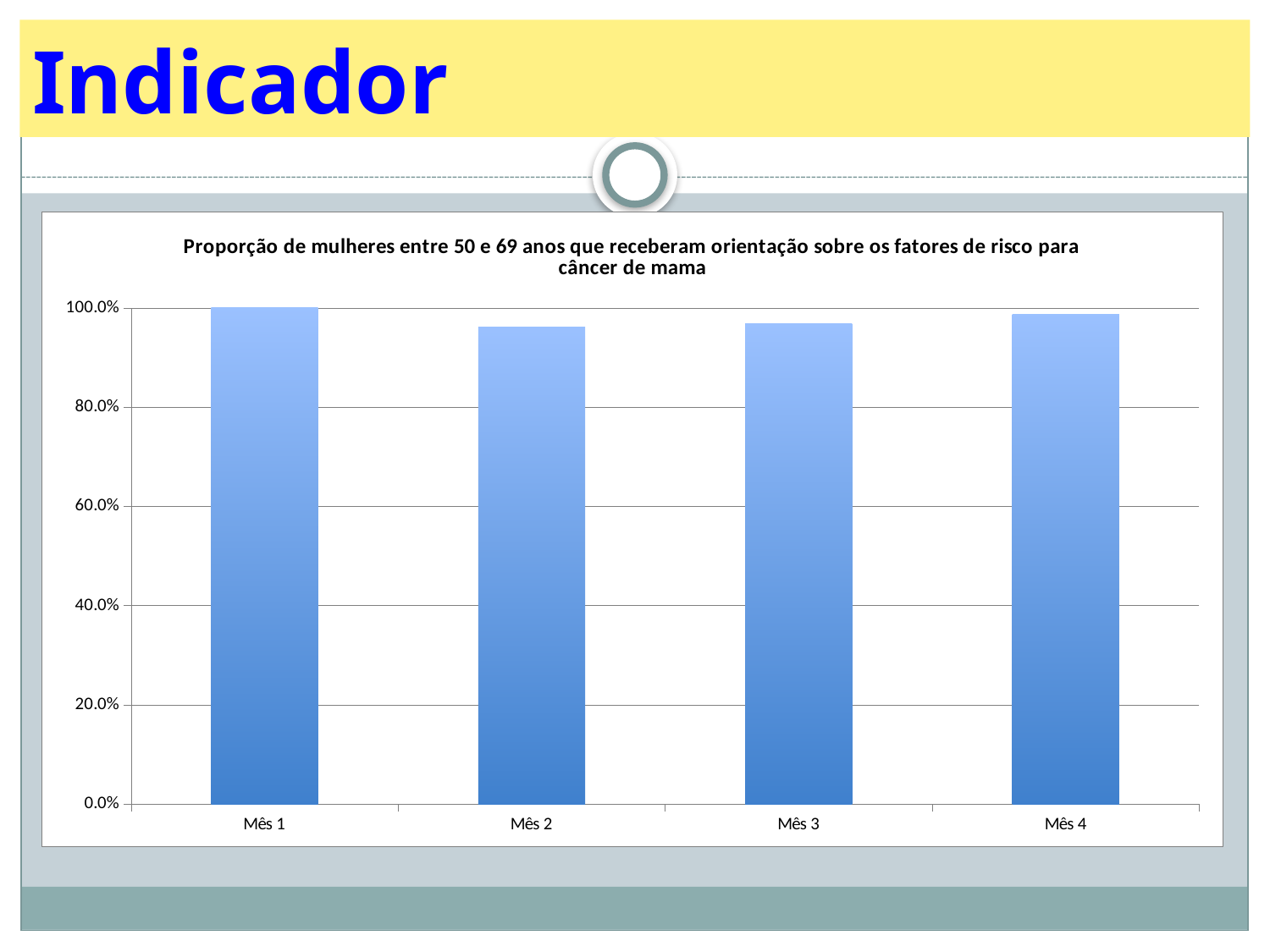
Which is larger, the value for Mês 1 or the value for Mês 2? Mês 1 How many categories (months) are shown on the x axis of the chart? 4 Which is larger, the value for Mês 4 or the value for Mês 2? Mês 4 Which month has the highest value in the chart? Mês 1 Is the value for Mês 2 greater or less than 80.0%? greater What kind of chart is shown on the slide? bar chart What is the highest value shown on the y axis of the chart? 100.0% What is the value for Mês 1 in the chart? 100.0% Is the value for Mês 4 greater or less than 100.0%? less Is the value for Mês 3 greater or less than 60.0%? greater What is the title of the chart? Proporção de mulheres entre 50 e 69 anos que receberam orientação sobre os fatores de risco para câncer de mama